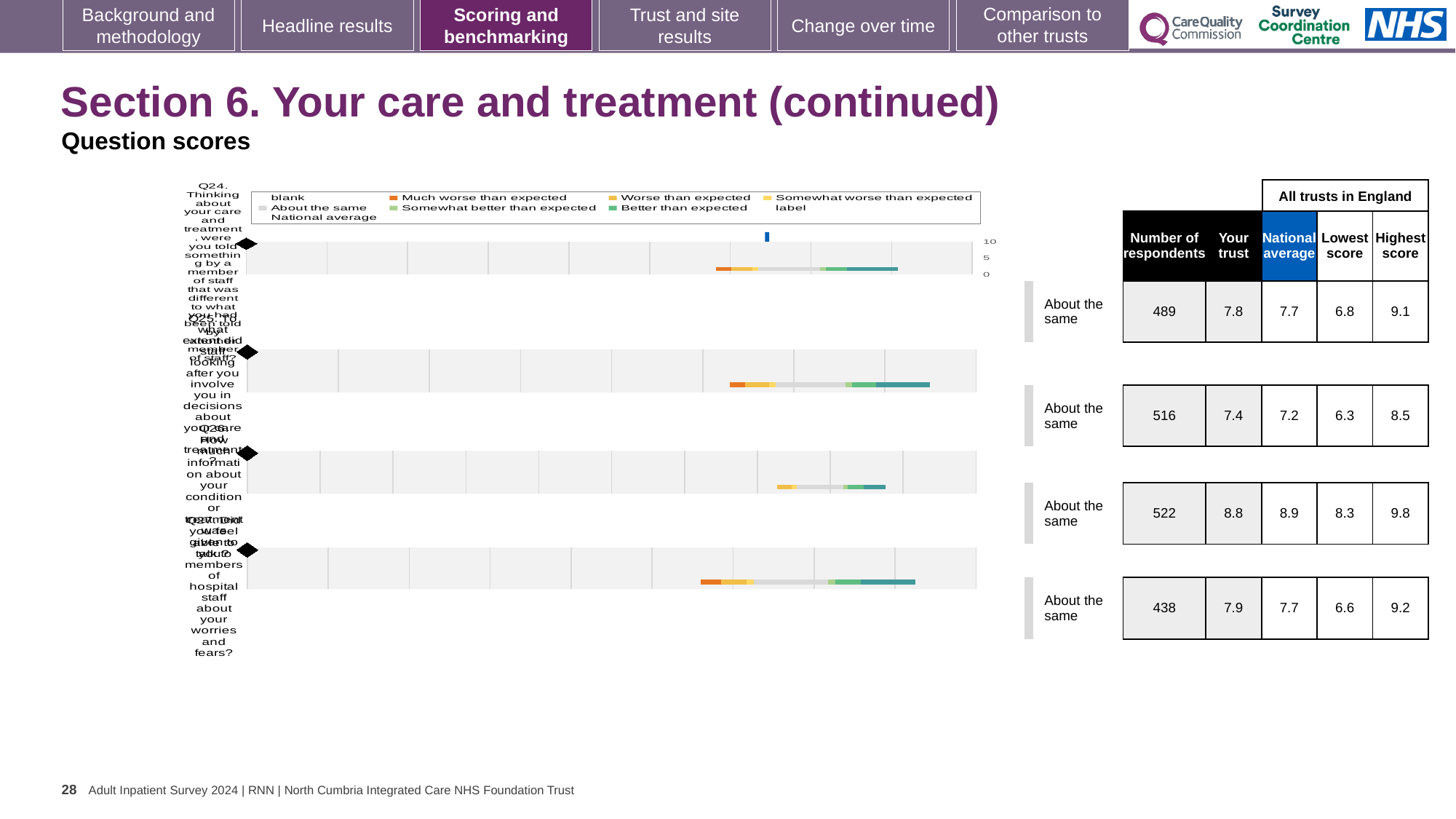
Which question has the highest 'Your trust' score? Q26 Which question has the lowest 'Your trust' score? Q25 For Q26, what is the difference between the highest score and the lowest score across all trusts in England? 1.5 What is the highest tick value shown on the x axis of the Q24 chart? 10 How many question charts (Q24 to Q27) are shown on the slide? 4 What is the national average score for Q26 (how much information about your condition or treatment was given to you)? 8.9 What kind of chart is used to show the question scores for Q24 to Q27? bar chart What is the 'Your trust' score for Q24 (being told something different by another member of staff)? 7.8 For Q24, which is larger: the 'Your trust' score or the national average? Your trust How many respondents answered Q27 (feeling able to talk to hospital staff about worries and fears)? 438 What is the lowest score across all trusts in England for Q25 (staff involving you in decisions about your care and treatment)? 6.3 What benchmark category is shown for Q25 (staff involving you in decisions about your care and treatment)? About the same